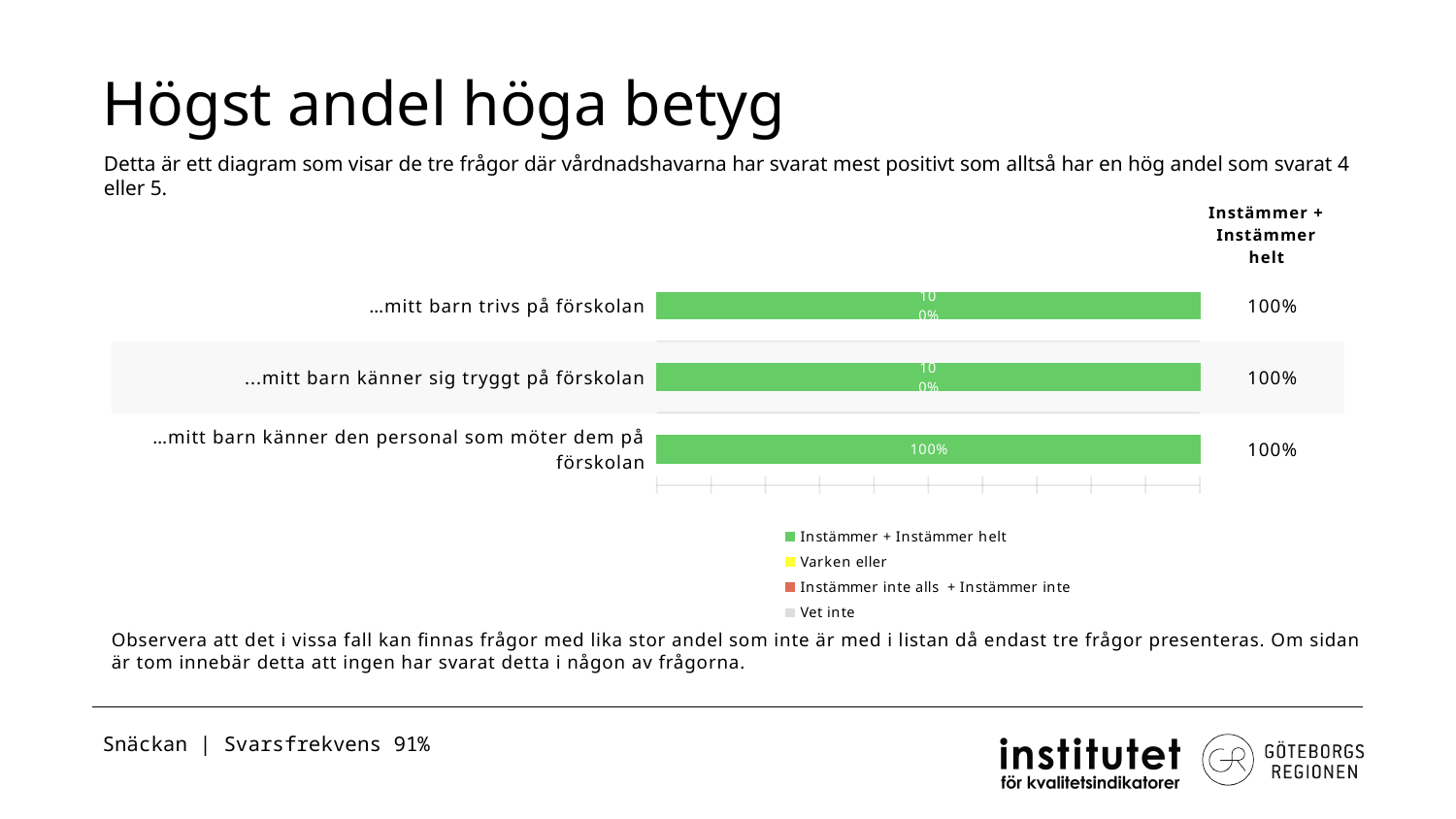
How many series does the chart legend list? 4 What kind of chart is shown on the slide? bar chart What is the difference between the 'Instämmer + Instämmer helt' shares for '…mitt barn trivs på förskolan' and '…mitt barn känner den personal som möter dem på förskolan'? 0% How many questions (categories) are plotted in the chart? 3 What is the 'Instämmer + Instämmer helt' share for '...mitt barn känner sig tryggt på förskolan'? 100% What is the 'Instämmer + Instämmer helt' share for '…mitt barn känner den personal som möter dem på förskolan'? 100% Which legend entry is shown in green? Instämmer + Instämmer helt What is the 'Instämmer + Instämmer helt' share for '…mitt barn trivs på förskolan'? 100% What is the title of the slide containing the chart? Högst andel höga betyg Which legend entry is shown in yellow? Varken eller